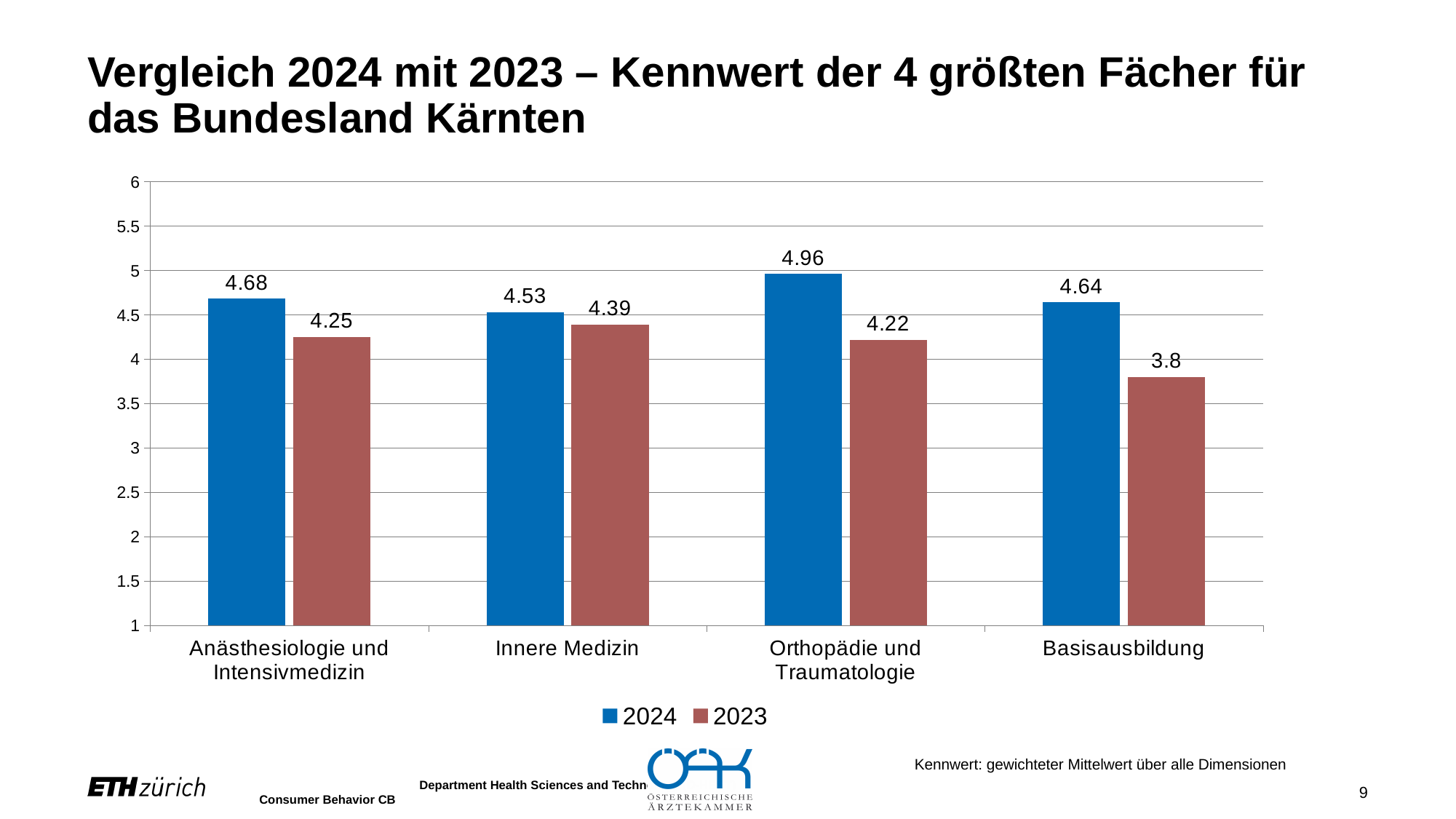
Which colour represents the 2023 series? Red (brownish red) What is the 2024 value for Orthopädie und Traumatologie? 4.96 How many series does the legend list? 2 What is the 2023 value for Innere Medizin? 4.39 Which is larger: the 2024 value for Innere Medizin or the 2024 value for Basisausbildung? Basisausbildung Which category has the highest 2024 value? Orthopädie und Traumatologie What kind of chart is shown on the slide? Bar chart What is the difference between the 2024 and 2023 values for Basisausbildung? 0.84 What is the difference between the 2024 and 2023 values for Anästhesiologie und Intensivmedizin? 0.43 Which category has the lowest 2023 value? Basisausbildung What is the 2023 value for Basisausbildung? 3.8 How many categories are shown on the x axis? 4